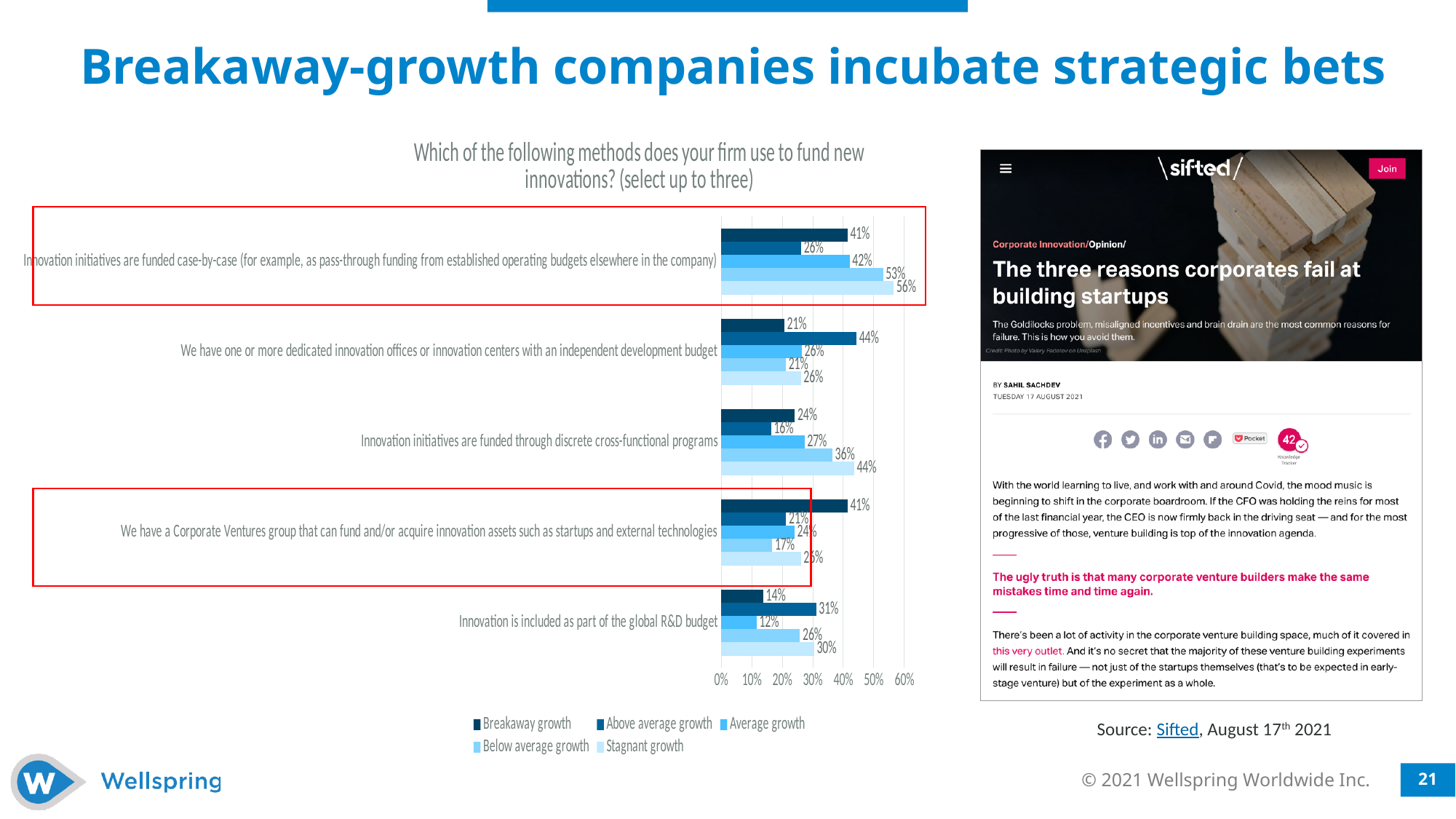
What is the difference between the Breakaway growth and Above average growth values for 'We have a Corporate Ventures group'? 20% What is the title of the chart? Which of the following methods does your firm use to fund new innovations? (select up to three) Which series has the lowest value for 'Innovation is included as part of the global R&D budget'? Average growth Which series has the highest value for 'Innovation initiatives are funded through discrete cross-functional programs'? Stagnant growth What type of chart is shown on the slide? bar chart How many series does the chart legend list? 5 What is the Average growth value for 'Innovation is included as part of the global R&D budget'? 12% For 'Innovation initiatives are funded case-by-case', which is larger: the Breakaway growth value or the Above average growth value? Breakaway growth What is the Breakaway growth value for 'We have a Corporate Ventures group that can fund and/or acquire innovation assets such as startups and external technologies'? 41% What is the Above average growth value for 'We have one or more dedicated innovation offices or innovation centers with an independent development budget'? 44% What is the Stagnant growth value for 'Innovation initiatives are funded case-by-case'? 56% How many funding methods (categories) are shown in the chart? 5